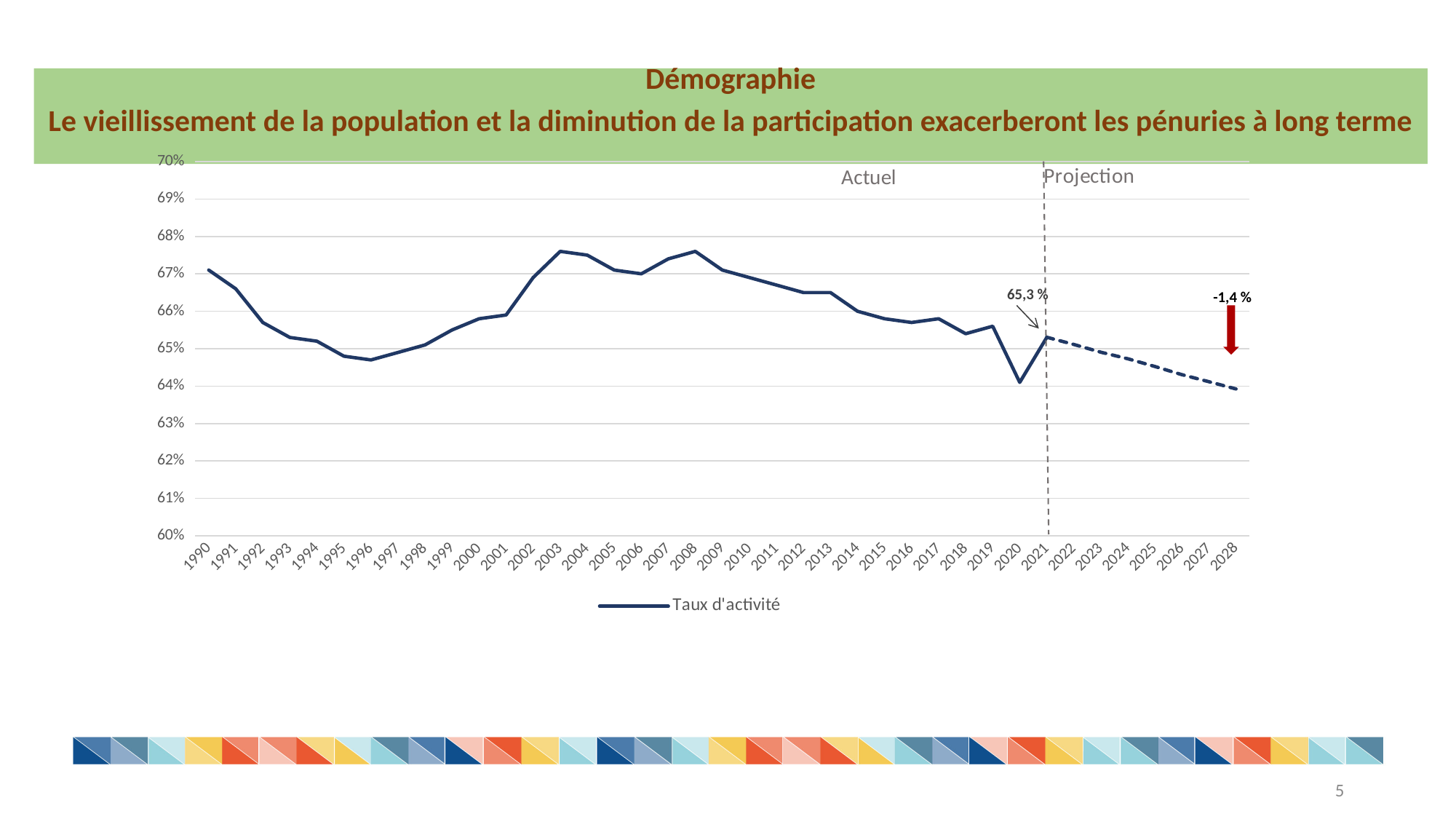
Is the value for 1996 greater or less than 65%? less What is the name of the series shown in the legend? Taux d'activité Is the value for 2003 greater or less than 67%? greater What kind of chart is shown on the slide? line chart Which is larger, the value for 1990 or the value for 2020? 1990 Is the value for 2020 greater or less than 65%? less What value is labelled on the chart for the year 2021? 65,3 % Does the projected line rise or fall from 2021 to 2028? fall Among the solid-line years 1990 to 2021, which year has the lowest value? 2020 How many series does the legend list? 1 What change is indicated by the red arrow annotation at the right of the chart? -1,4 % How many years are shown on the x axis of the chart? 39